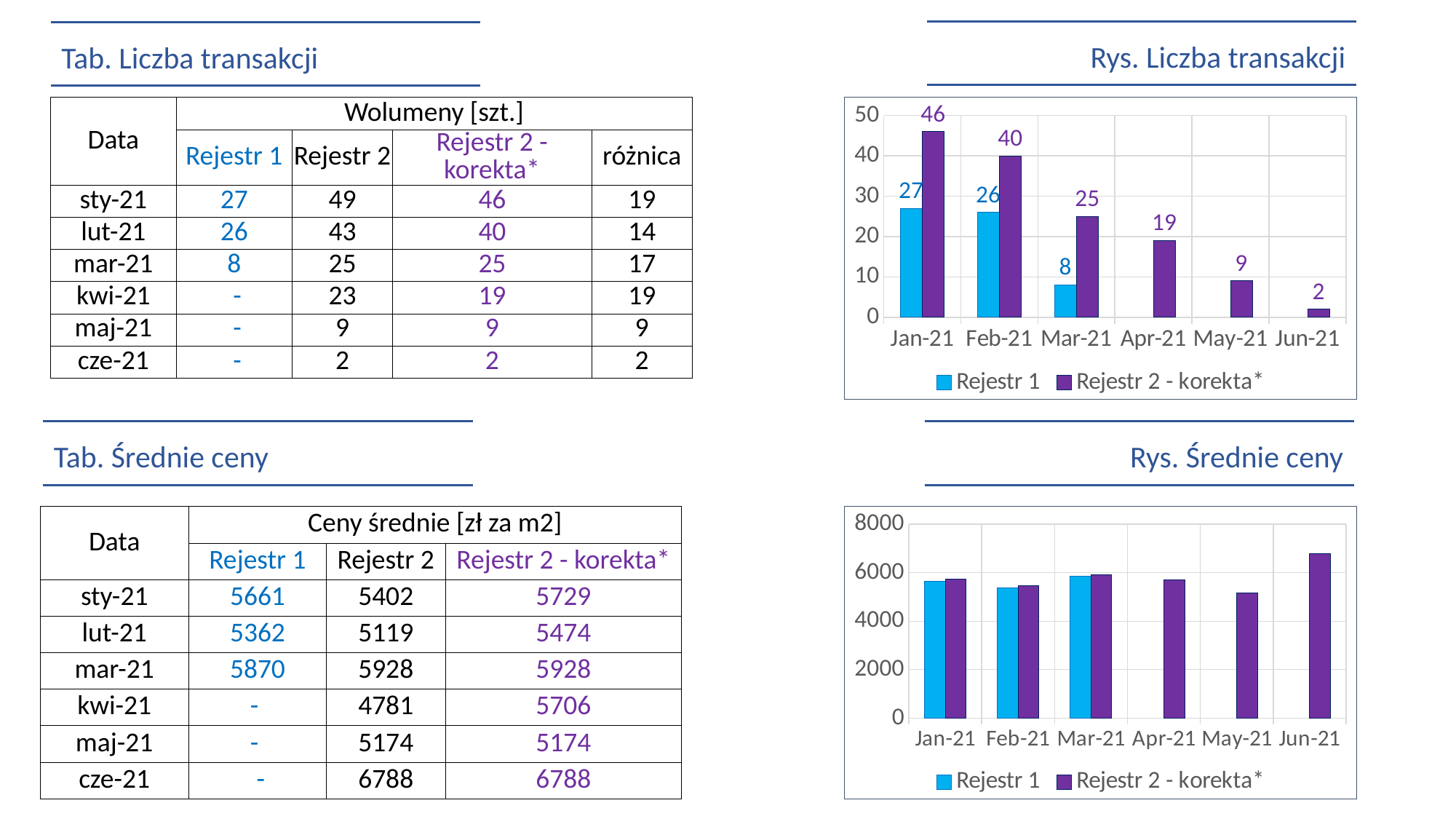
In the chart titled 'Rys. Liczba transakcji', do the values for Rejestr 2 - korekta* rise or fall from Jan-21 to Jun-21? fall In the chart titled 'Rys. Liczba transakcji', which month has the lowest value for Rejestr 2 - korekta*? Jun-21 In the chart titled 'Rys. Liczba transakcji', what is the value for Rejestr 1 in Mar-21? 8 In the chart titled 'Rys. Liczba transakcji', which month has the highest value for Rejestr 2 - korekta*? Jan-21 How many series does the legend of the chart titled 'Rys. Liczba transakcji' list? 2 What kind of chart is the chart titled 'Rys. Średnie ceny'? bar chart In the chart titled 'Rys. Liczba transakcji', what is the value for Rejestr 2 - korekta* in Jan-21? 46 In the chart titled 'Rys. Liczba transakcji', what is the difference between Rejestr 2 - korekta* and Rejestr 1 in Feb-21? 14 In the chart titled 'Rys. Liczba transakcji', which is larger in Mar-21: Rejestr 1 or Rejestr 2 - korekta*? Rejestr 2 - korekta* In the chart titled 'Rys. Średnie ceny', which month has the highest value for Rejestr 2 - korekta*? Jun-21 In the chart titled 'Rys. Średnie ceny', is the value for Rejestr 2 - korekta* in Jun-21 greater or less than 6000? greater How many months are shown on the x axis of the chart titled 'Rys. Średnie ceny'? 6